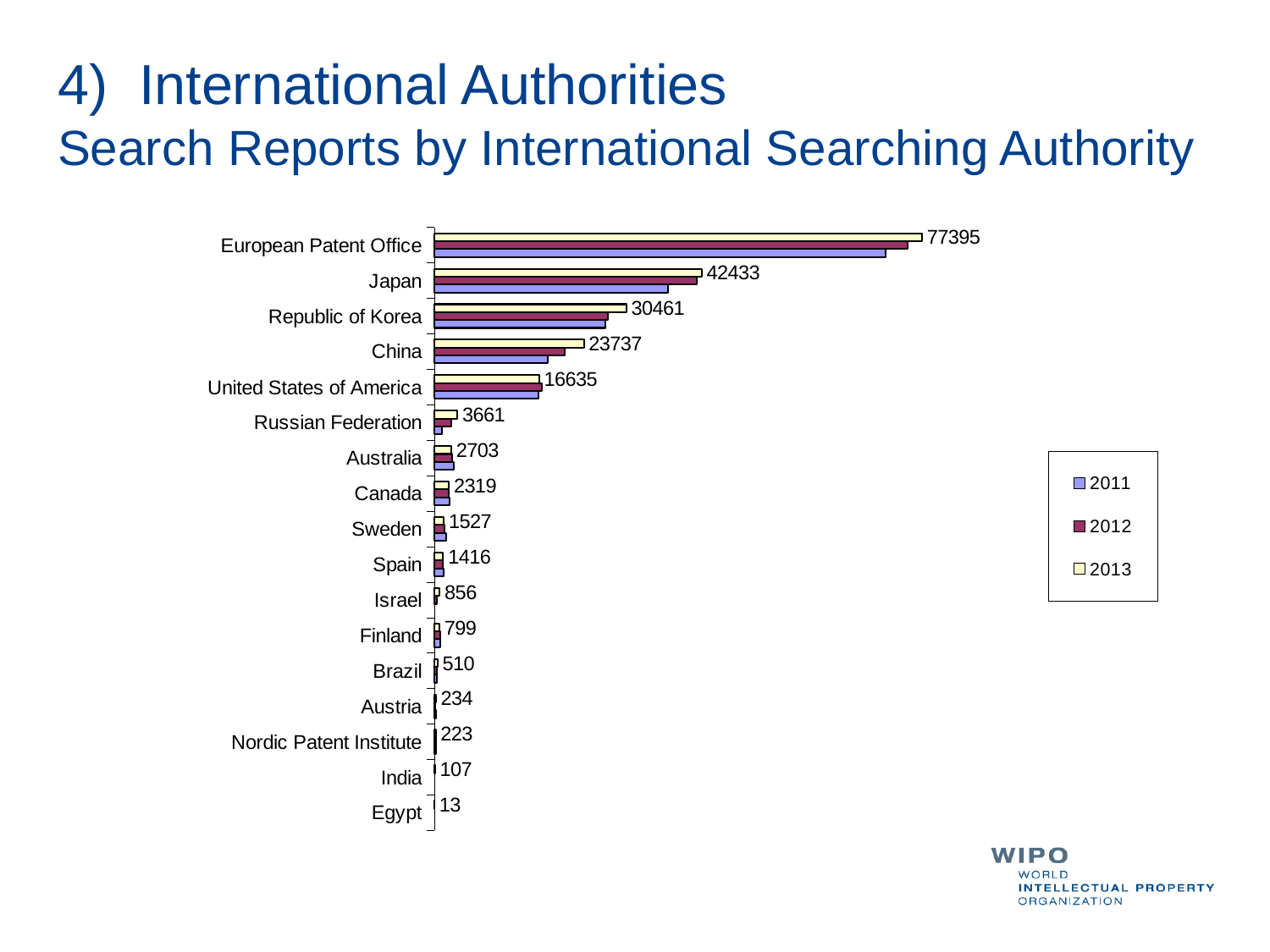
Which years are listed in the legend? 2011, 2012, 2013 Which International Searching Authority has the lowest 2013 value? Egypt What is the difference between the 2013 values for Japan and the Republic of Korea? 11972 What is the 2013 value for Egypt? 13 What is the 2013 value for the European Patent Office? 77395 What kind of chart is shown on the slide? Bar chart What is the 2013 value for Japan? 42433 Which has the larger 2013 value, China or the United States of America? China What is the 2013 value for the Russian Federation? 3661 Which International Searching Authority has the highest 2013 value? European Patent Office How many International Searching Authorities are listed on the chart? 17 How many series does the legend list? 3